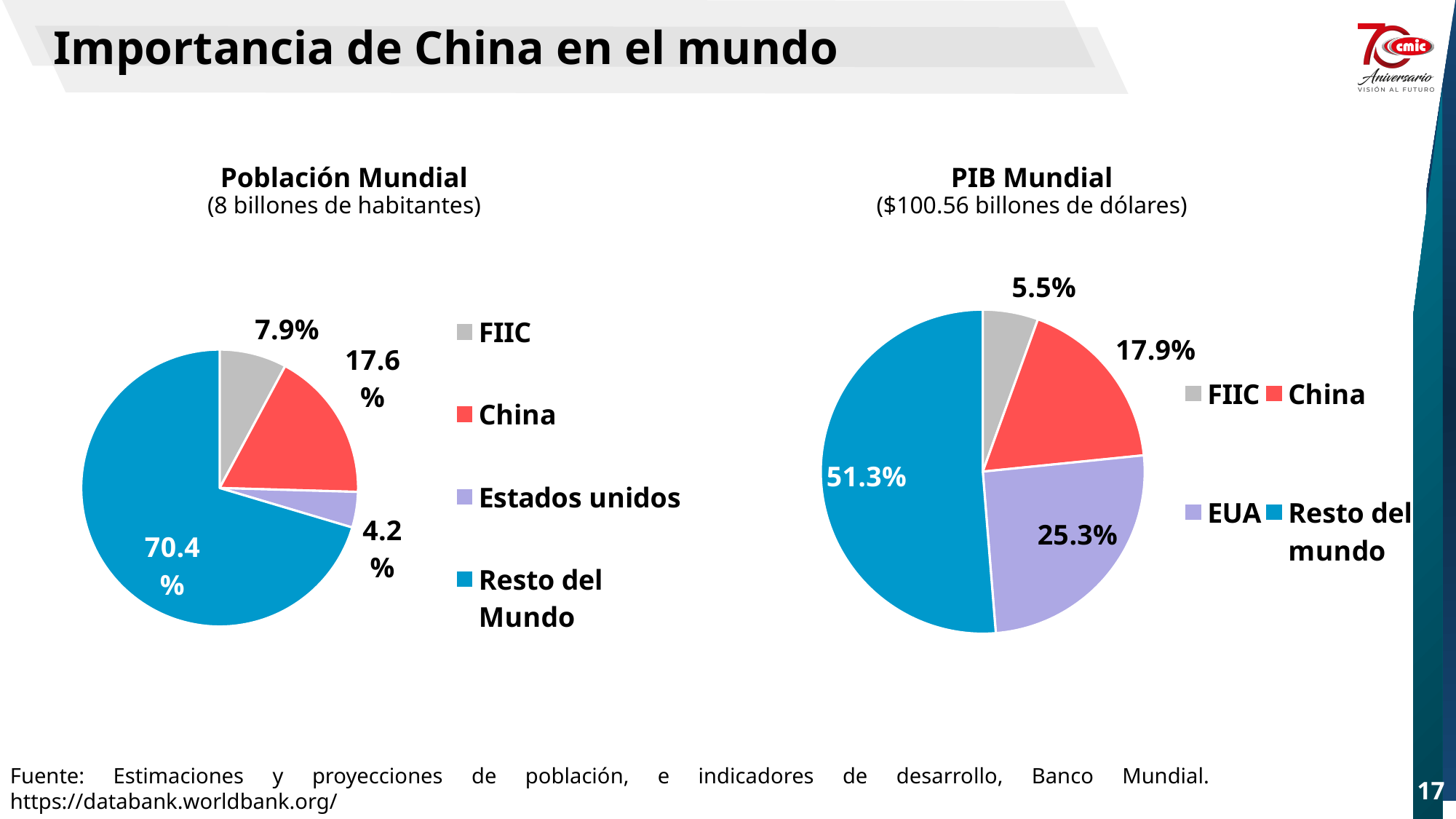
What kind of chart is the 'Población Mundial' chart? Pie chart In the 'PIB Mundial' chart, what share does FIIC have? 5.5% In the 'Población Mundial' chart, which category has the smallest slice? Estados unidos In the 'Población Mundial' chart, what share does Estados unidos have? 4.2% In the 'PIB Mundial' chart, what colour is the slice for Resto del mundo? Blue In the 'Población Mundial' chart, which is larger, the share of China or the share of FIIC? China In the 'Población Mundial' chart, what share does China have? 17.6% In the 'PIB Mundial' chart, what is the difference between the shares of EUA and China? 7.4% In the 'Población Mundial' chart, which category has the largest slice? Resto del Mundo In the 'PIB Mundial' chart, which category has the smallest slice? FIIC How many slices does the 'PIB Mundial' chart have? 4 In the 'PIB Mundial' chart, what share does EUA have? 25.3%